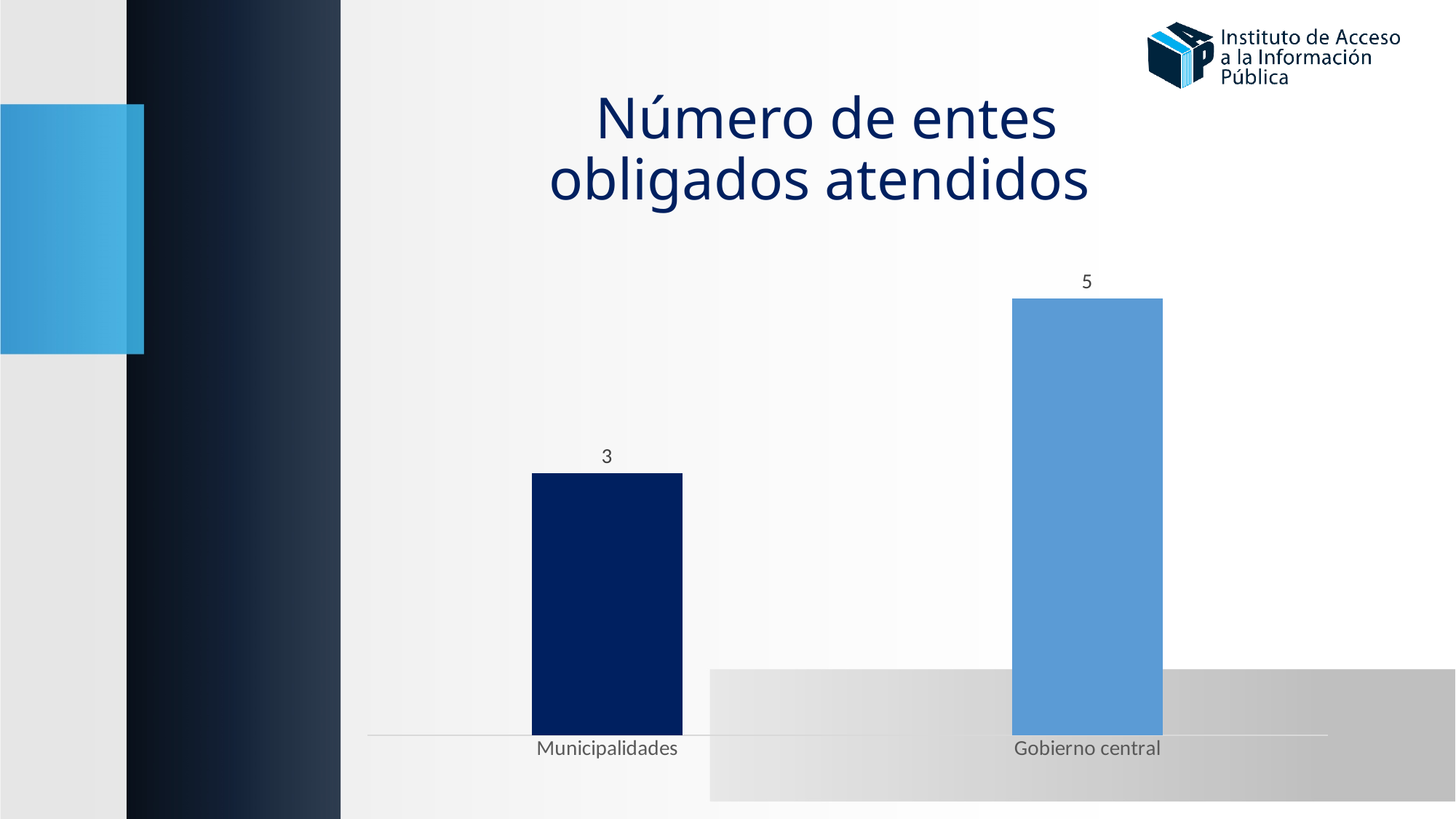
What is the value for Municipalidades? 3 Which category has the lowest value? Municipalidades What is the total of the two bars in the chart? 8 Do the values rise or fall from Municipalidades to Gobierno central? Rise What is the value for Gobierno central? 5 How many categories are shown in the chart? 2 What is the title of the chart on the slide? Número de entes obligados atendidos Which is larger, the value for Municipalidades or the value for Gobierno central? Gobierno central What is the difference between the values for Gobierno central and Municipalidades? 2 Which category has the highest value? Gobierno central What colour is the bar for Gobierno central? Light blue What kind of chart is shown on the slide? Bar chart